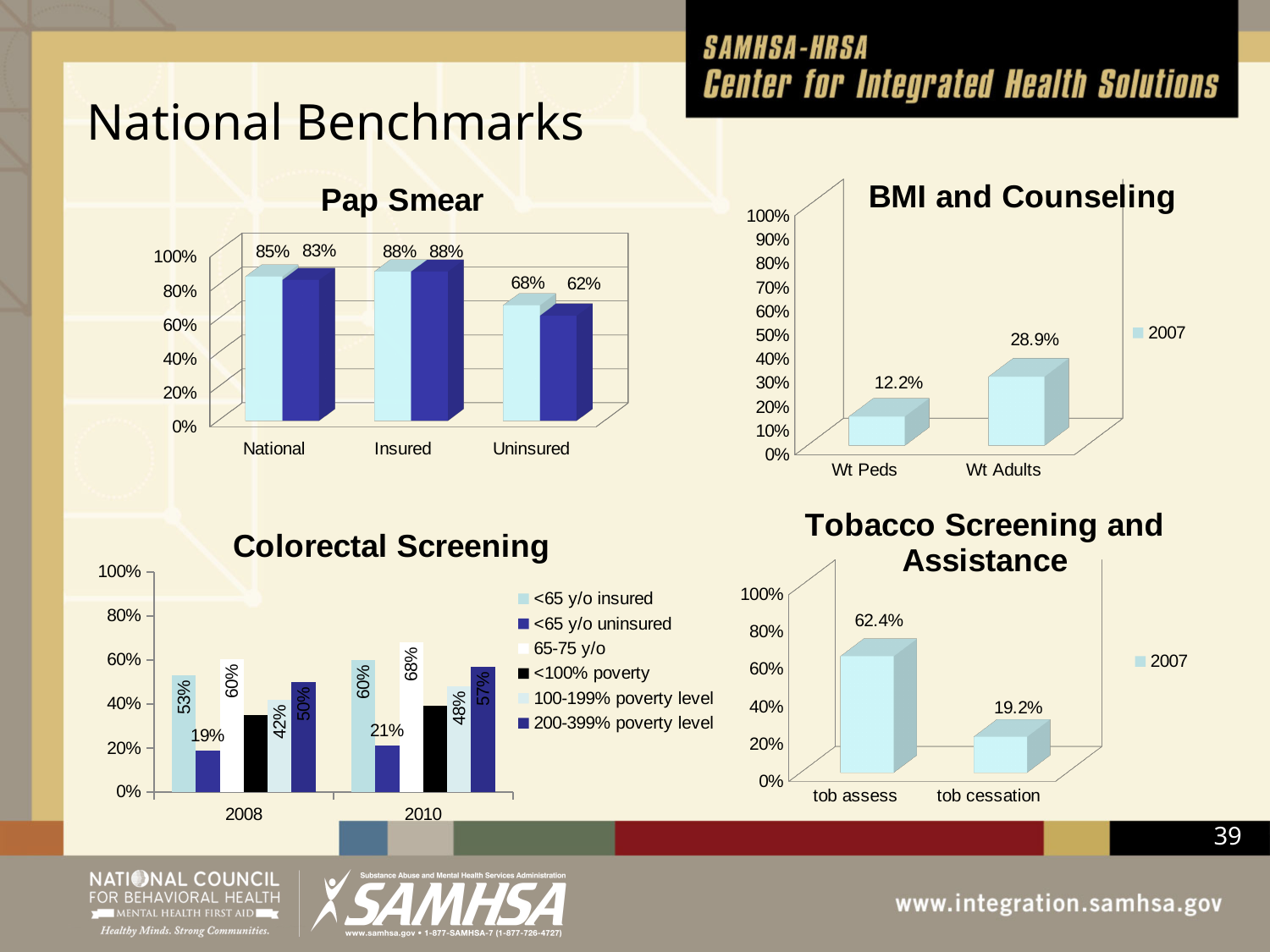
In the Pap Smear chart, what are the two values shown for Uninsured? 68% and 62% In the Colorectal Screening chart, how many series does the legend list? 6 In the BMI and Counseling chart, what is the value for Wt Adults? 28.9% In the Tobacco Screening and Assistance chart, what is the value for tob assess? 62.4% In the Colorectal Screening chart, what is the value for <65 y/o uninsured in 2008? 19% In the Pap Smear chart, how many categories are shown on the x axis? 3 In the Pap Smear chart, which category has the highest values? Insured In the Tobacco Screening and Assistance chart, what is the difference between tob assess and tob cessation? 43.2% In the Colorectal Screening chart, is the value for <100% poverty in 2010 greater or less than 20%? greater In the BMI and Counseling chart, what is the value for Wt Peds? 12.2% In the Tobacco Screening and Assistance chart, which category has the lower value? tob cessation In the Colorectal Screening chart, what is the value for 65-75 y/o in 2010? 68%